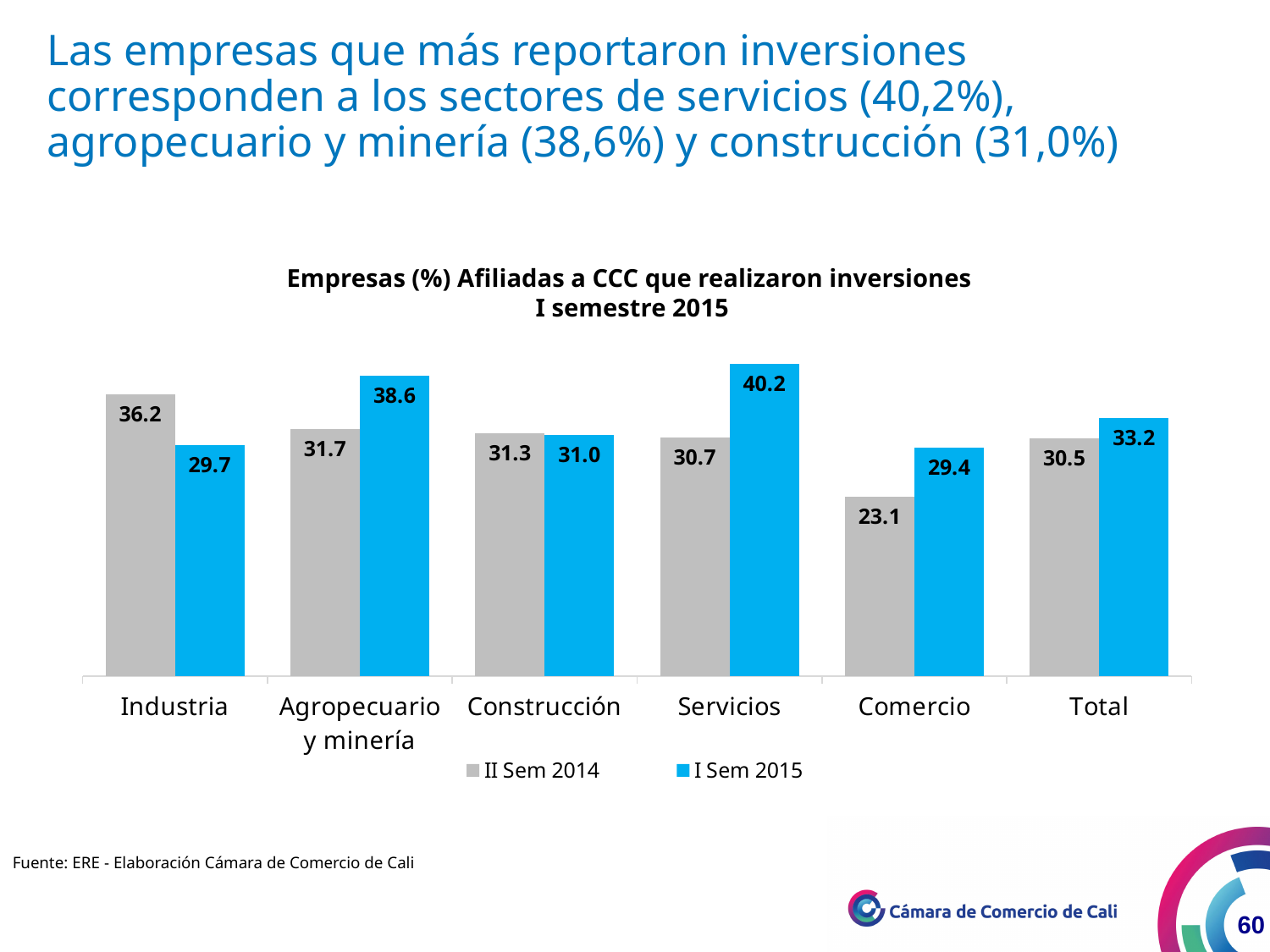
What is the difference between the II Sem 2014 and I Sem 2015 values for Industria? 6.5 Which category has the lowest value in the II Sem 2014 series? Comercio What is the title of the chart? Empresas (%) Afiliadas a CCC que realizaron inversiones I semestre 2015 How many categories are shown on the x axis? 6 What is the value for Servicios in the I Sem 2015 series? 40.2 What is the value for Industria in the I Sem 2015 series? 29.7 What kind of chart is shown on the slide? Bar chart What is the value for Comercio in the II Sem 2014 series? 23.1 Which is larger for Agropecuario y minería: the II Sem 2014 value or the I Sem 2015 value? I Sem 2015 How many series does the legend list? 2 What is the difference between the I Sem 2015 and II Sem 2014 values for Servicios? 9.5 Which category has the highest value in the I Sem 2015 series? Servicios